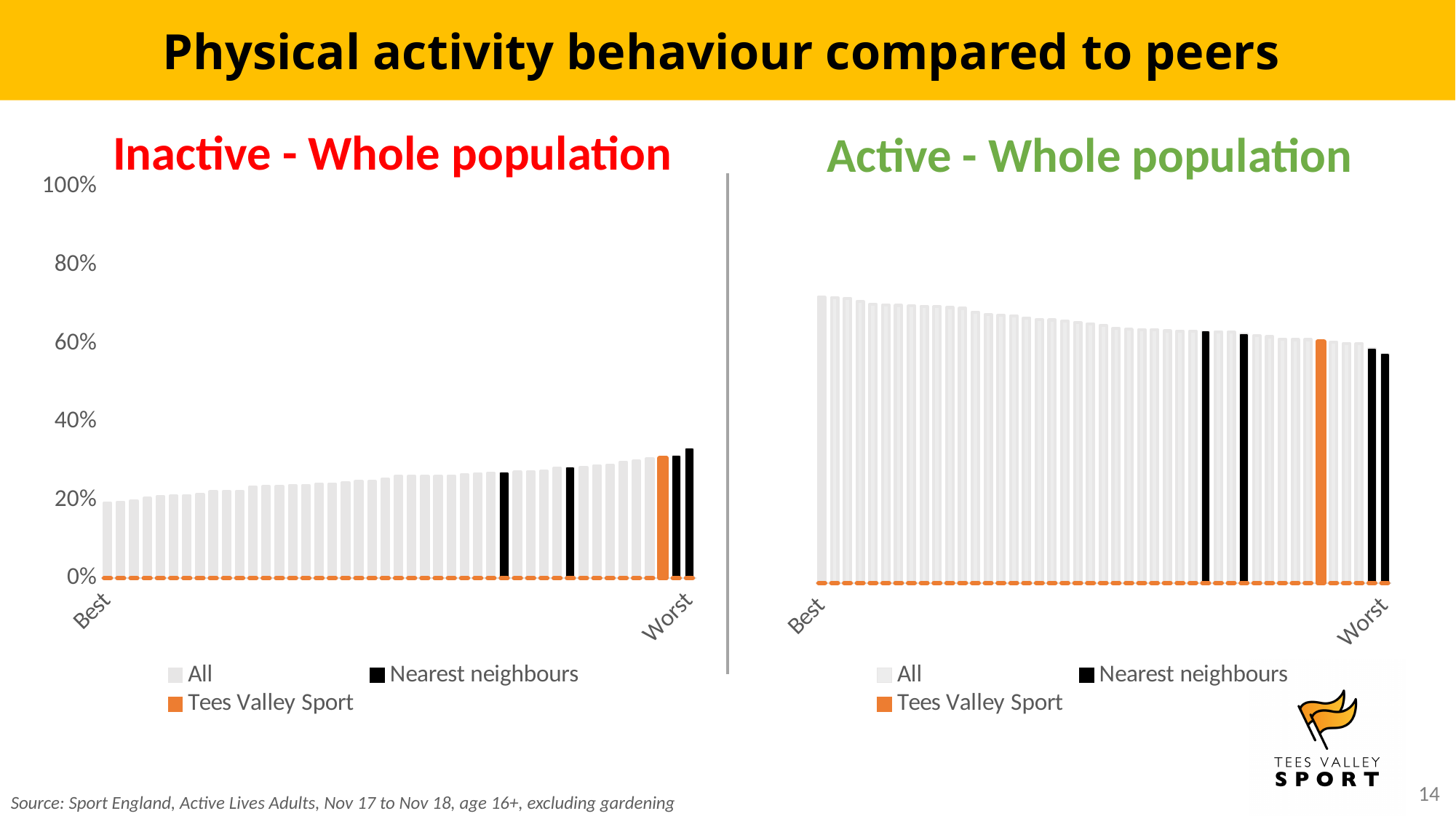
In the "Inactive - Whole population" chart, is the value for Tees Valley Sport greater or less than 40%? less In the "Inactive - Whole population" chart, is the value for Tees Valley Sport greater or less than 20%? greater How many series does the legend of the "Inactive - Whole population" chart list? 3 How many series does the legend of the "Active - Whole population" chart list? 3 What kind of chart is the "Inactive - Whole population" chart? Bar chart What kind of chart is the "Active - Whole population" chart? Bar chart In the "Active - Whole population" chart, is the value for Tees Valley Sport greater or less than 80%? less Which series is shown in orange in the "Inactive - Whole population" chart? Tees Valley Sport In the "Active - Whole population" chart, do the bar values rise or fall from Best to Worst along the x axis? Fall In the "Inactive - Whole population" chart, do the bar values rise or fall from Best to Worst along the x axis? Rise